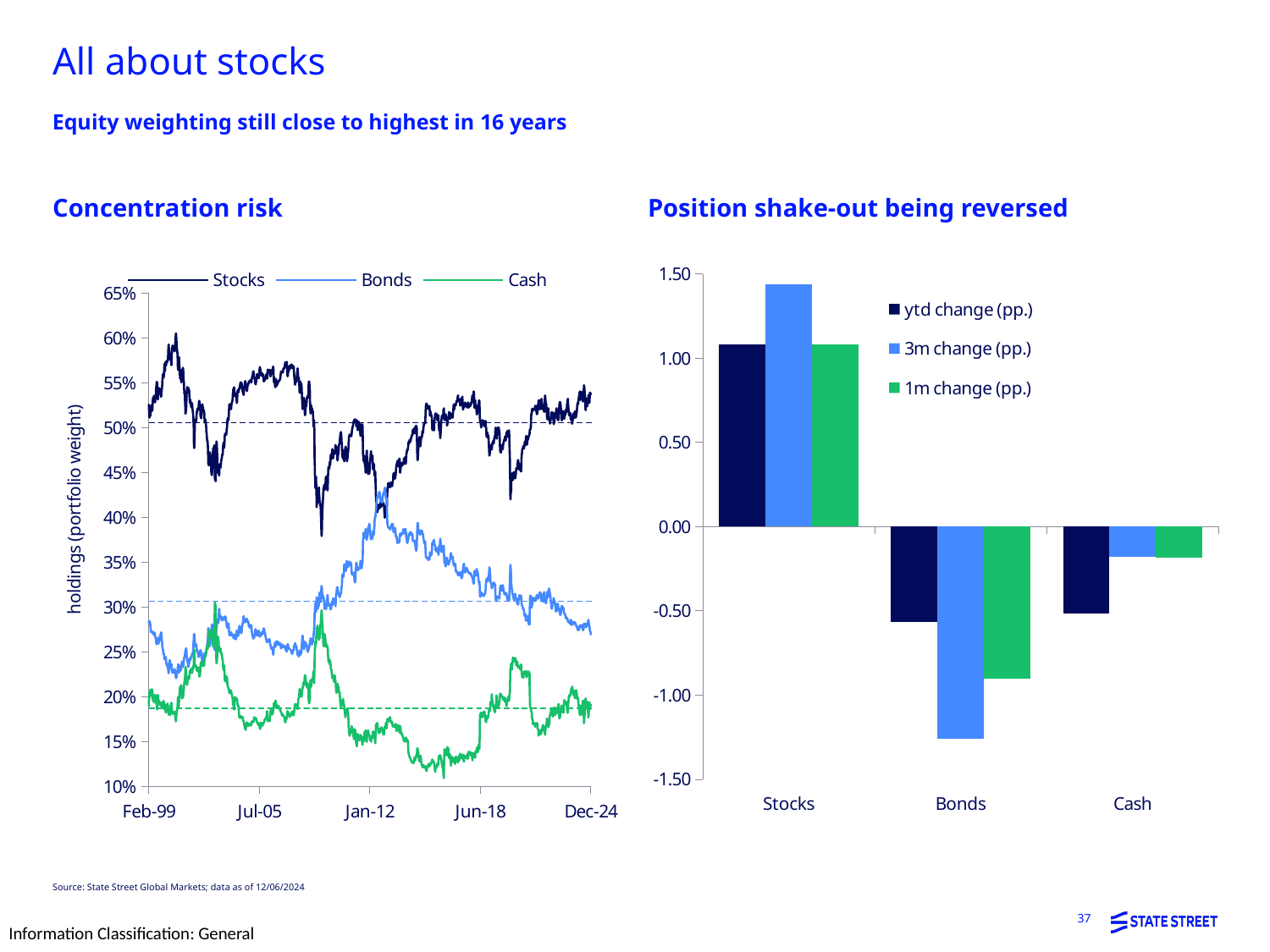
How many series does the legend of the 'Position shake-out being reversed' chart list? 3 In the 'Position shake-out being reversed' chart, is the 3m change (pp.) for Stocks greater or less than 1.00? greater In the 'Position shake-out being reversed' chart, which category has the lowest 3m change (pp.)? Bonds In the 'Position shake-out being reversed' chart, which is larger, the 1m change (pp.) for Bonds or for Cash? Cash How many series does the legend of the 'Concentration risk' chart list? 3 In the 'Position shake-out being reversed' chart, is the 3m change (pp.) for Bonds greater or less than -1.00? less In the 'Position shake-out being reversed' chart, which category has the highest 3m change (pp.)? Stocks What kind of chart is the 'Concentration risk' chart? line chart In the 'Concentration risk' chart, is the Stocks holding at Dec-24 greater or less than 50%? greater In the 'Concentration risk' chart, do the Bonds holdings rise or fall between Jan-12 and Dec-24? fall How many categories are shown on the x axis of the 'Position shake-out being reversed' chart? 3 What kind of chart is the 'Position shake-out being reversed' chart? bar chart